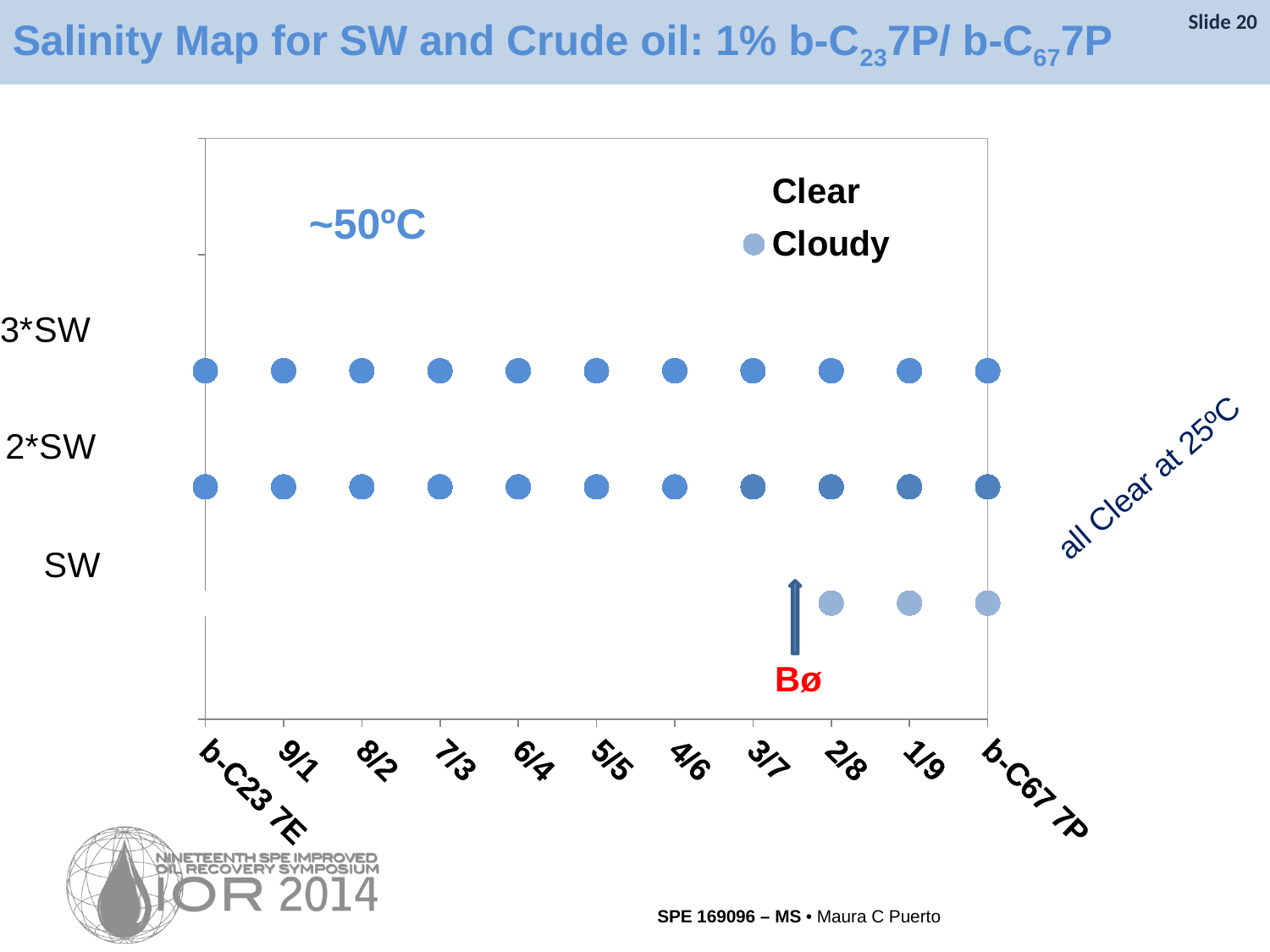
Which x-axis categories have a 'Cloudy' point plotted? 2/8, 1/9 and b-C67 7P How many categories are labelled along the x axis of the chart? 11 How many series does the chart legend list? 2 What are the two entries in the chart legend? Clear and Cloudy What kind of chart is shown on the slide? Scatter (dot) chart How many salinity levels are labelled on the y axis of the chart? 3 What temperature is annotated inside the plot area of the chart? ~50ºC What are the three salinity labels on the y axis? SW, 2*SW, 3*SW How many 'Cloudy' points are plotted on the chart? 3 What is the leftmost category label on the x axis? b-C23 7E What is the rightmost category label on the x axis? b-C67 7P